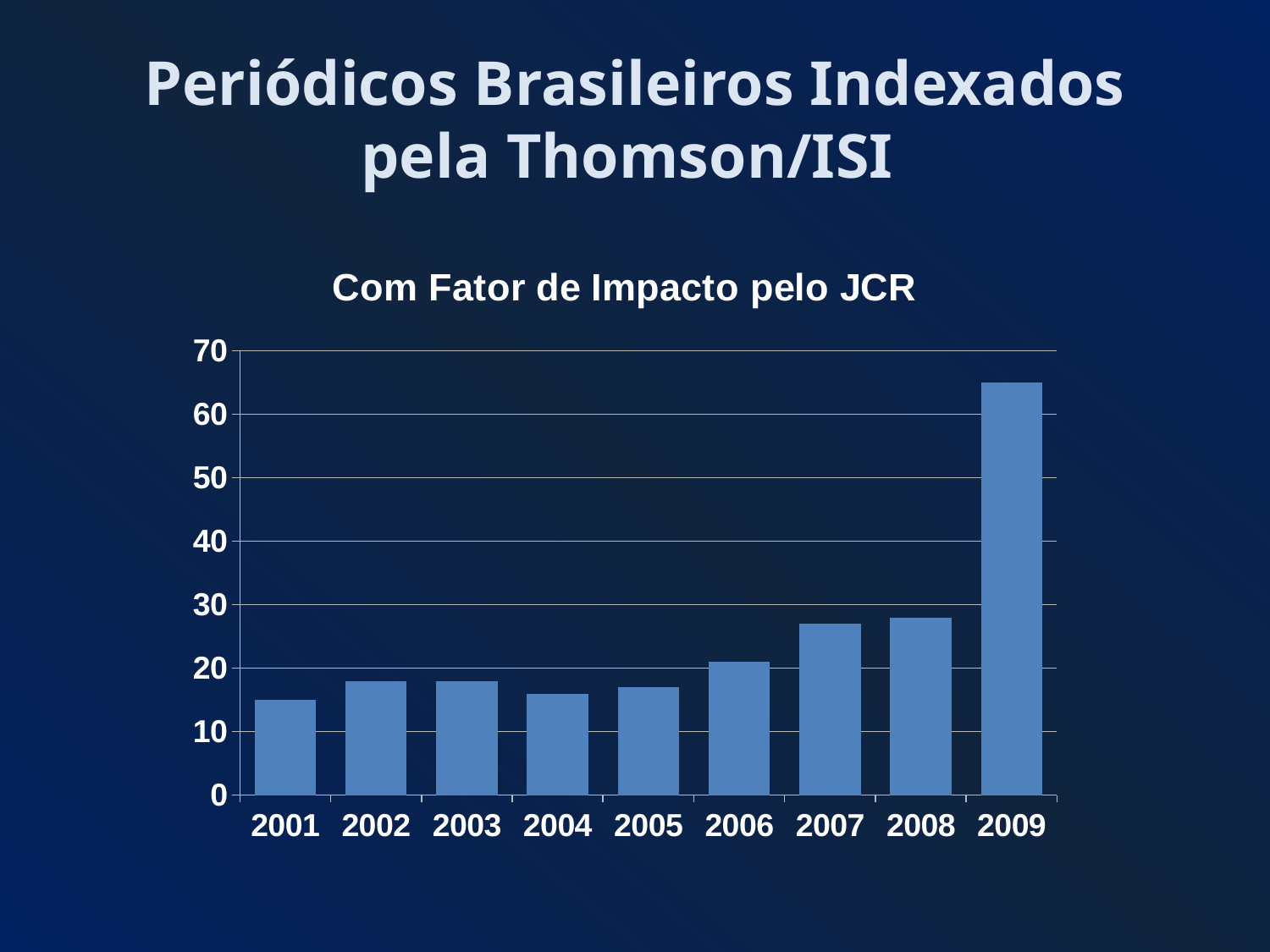
Is the value for 2008 greater or less than 20? greater Which is larger, the value for 2004 or the value for 2007? 2007 How many years are shown on the x axis of the chart? 9 Which is larger, the value for 2008 or the value for 2009? 2009 Do the values generally rise or fall from 2005 to 2009? rise Is the value for 2007 greater or less than 30? less Is the value for 2004 greater or less than 20? less What kind of chart is shown on the slide? Bar chart Which year has the highest value in the chart? 2009 What is the title printed above the chart? Com Fator de Impacto pelo JCR